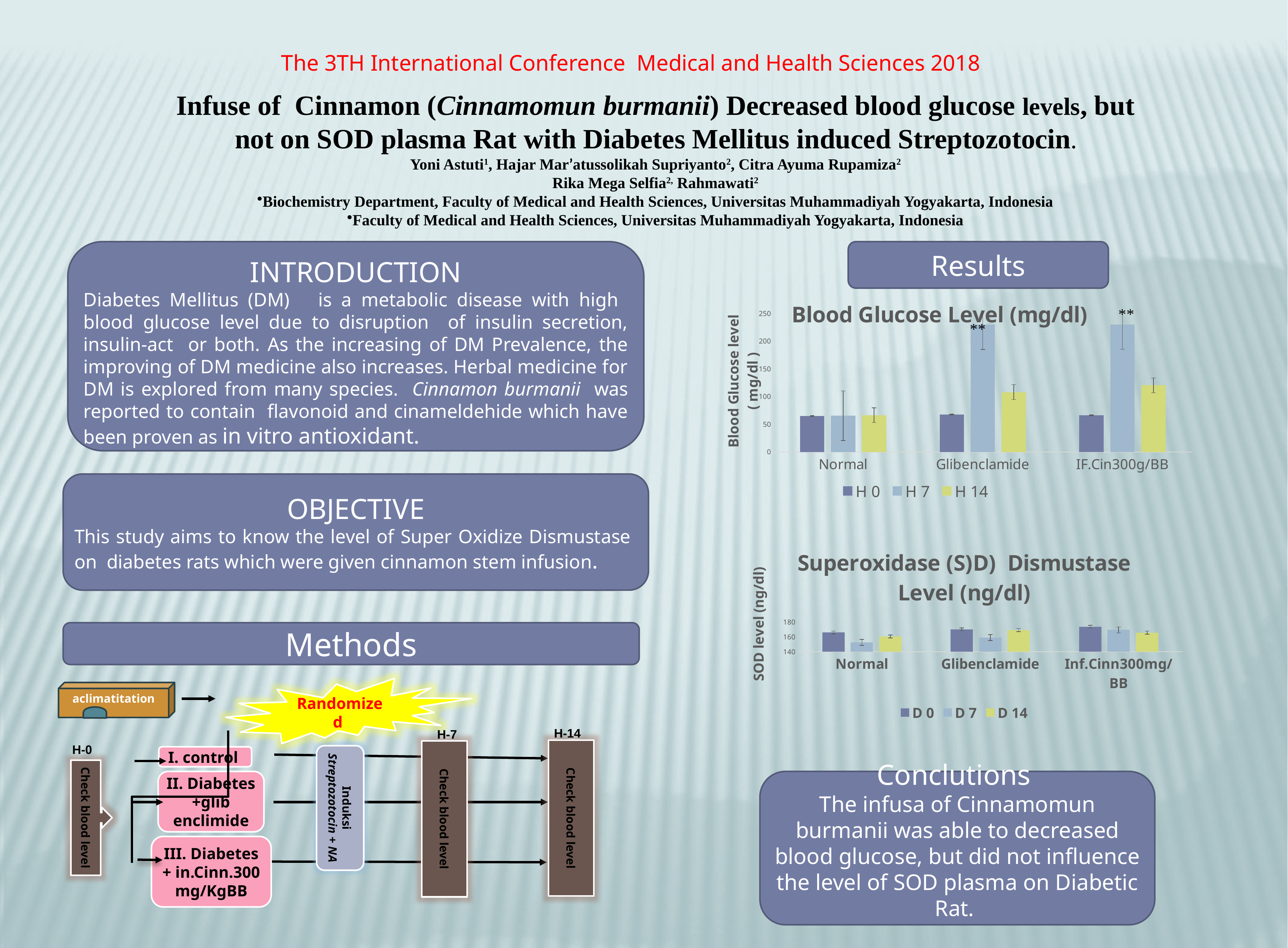
In the Blood Glucose Level (mg/dl) chart, is the H 7 value for Glibenclamide greater or less than 200? greater In the Blood Glucose Level (mg/dl) chart, which is larger for Glibenclamide: the H 7 value or the H 14 value? H 7 What kind of chart is the Blood Glucose Level (mg/dl) chart? bar chart In the Superoxidase (S)D) Dismustase Level (ng/dl) chart, which is larger for Normal: the D 0 value or the D 7 value? D 0 How many categories are shown on the x axis of the Blood Glucose Level (mg/dl) chart? 3 What kind of chart is the Superoxidase (S)D) Dismustase Level (ng/dl) chart? bar chart What are the legend entries of the Blood Glucose Level (mg/dl) chart? H 0, H 7, H 14 How many series does the legend of the Superoxidase (S)D) Dismustase Level (ng/dl) chart list? 3 How many series does the legend of the Blood Glucose Level (mg/dl) chart list? 3 In the Blood Glucose Level (mg/dl) chart, is the H 0 value for Normal greater or less than 100? less In the Blood Glucose Level (mg/dl) chart, which series has the highest value for IF.Cin300g/BB? H 7 In the Superoxidase (S)D) Dismustase Level (ng/dl) chart, is the D 7 value for Normal greater or less than 160? less